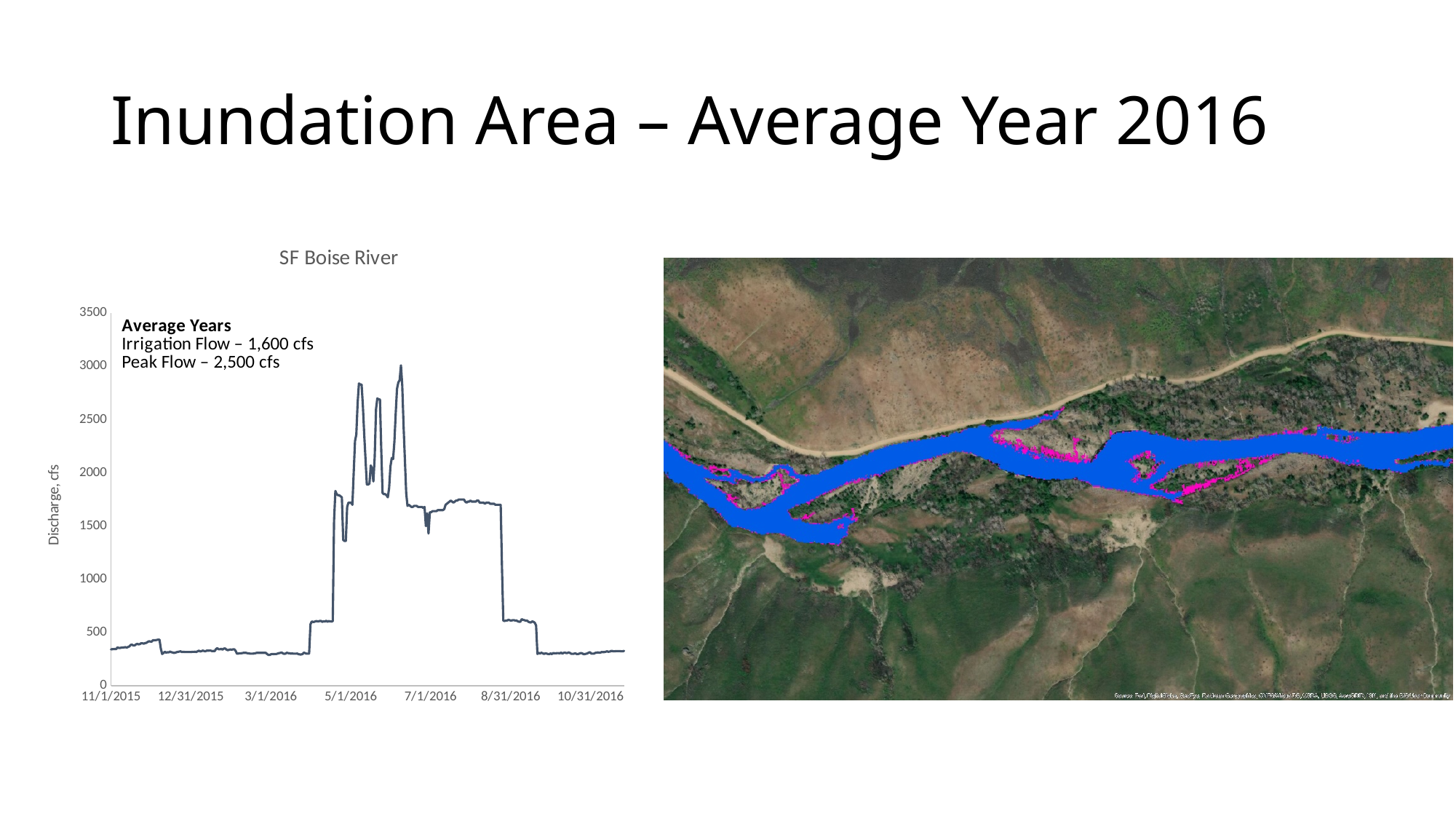
On the SF Boise River chart, is the discharge on 7/1/2016 greater or less than 1500? greater On the SF Boise River chart, is the discharge on 12/31/2015 greater or less than 1000? less On the SF Boise River chart, does the discharge rise or fall between 7/1/2016 and 10/31/2016? fall According to the annotation on the SF Boise River chart, what is the peak flow in average years? 2,500 cfs What is the title of the chart on the left of the slide? SF Boise River On the SF Boise River chart, is the discharge on 3/1/2016 greater or less than 500? less What is the label of the y-axis on the SF Boise River chart? Discharge, cfs According to the annotation on the SF Boise River chart, what is the irrigation flow in average years? 1,600 cfs On the SF Boise River chart, which date has the larger discharge, 3/1/2016 or 7/1/2016? 7/1/2016 What kind of chart is the SF Boise River chart? line chart